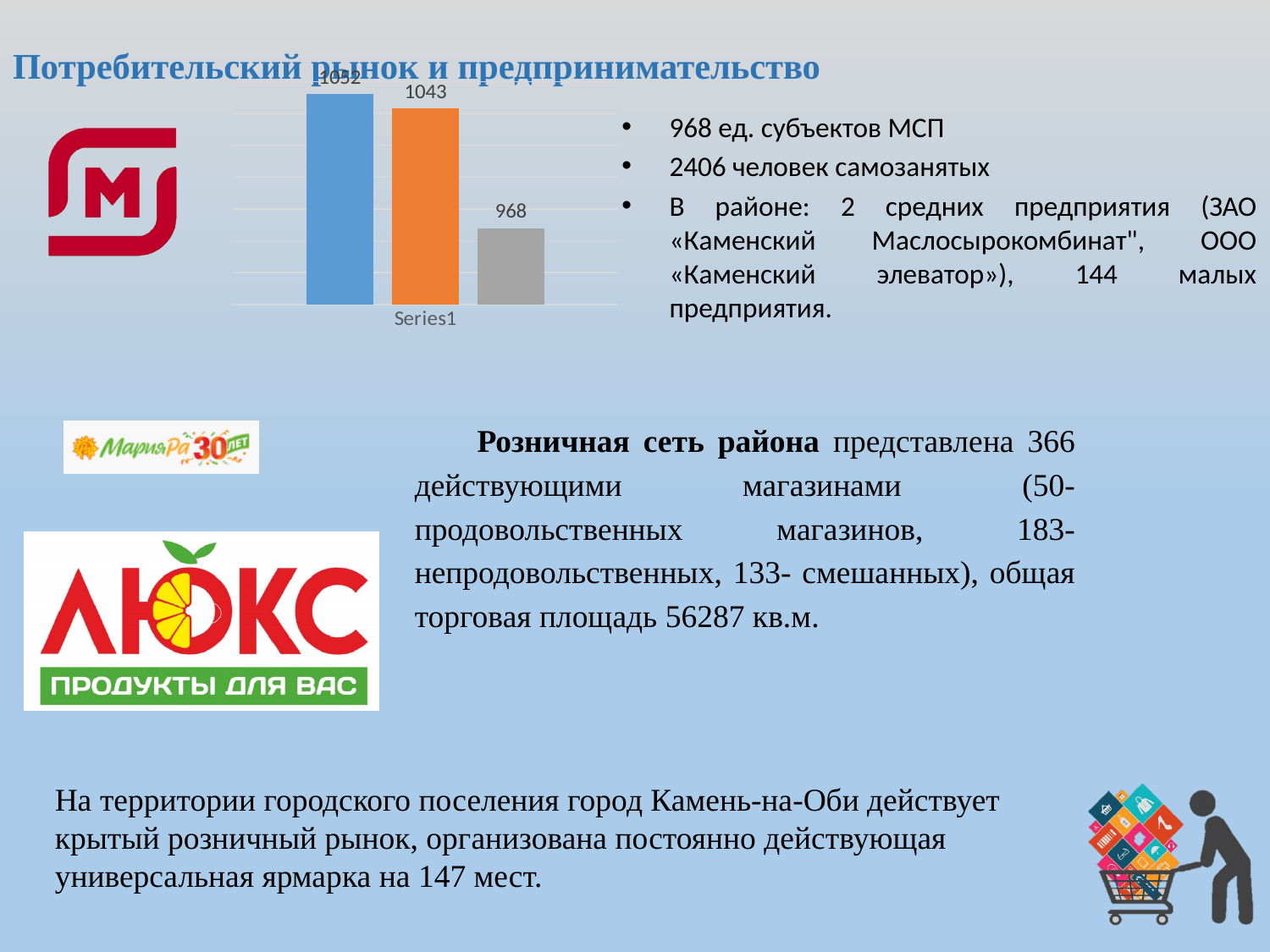
What is the difference between the orange bar and the gray bar in the chart? 75 What value is labelled on the blue bar in the chart? 1052 How many bars are plotted in the chart? 3 Which bar in the chart has the highest value? the blue bar (1052) Which bar in the chart has the lowest value? the gray bar (968) What type of chart is shown at the top of the slide? bar chart What value is labelled on the orange bar in the chart? 1043 What label is shown on the horizontal axis of the chart? Series1 Which is larger in the chart, the orange bar or the gray bar? the orange bar What is the difference between the blue bar and the gray bar in the chart? 84 Do the bar values rise or fall from left to right in the chart? fall What value is labelled on the gray bar in the chart? 968